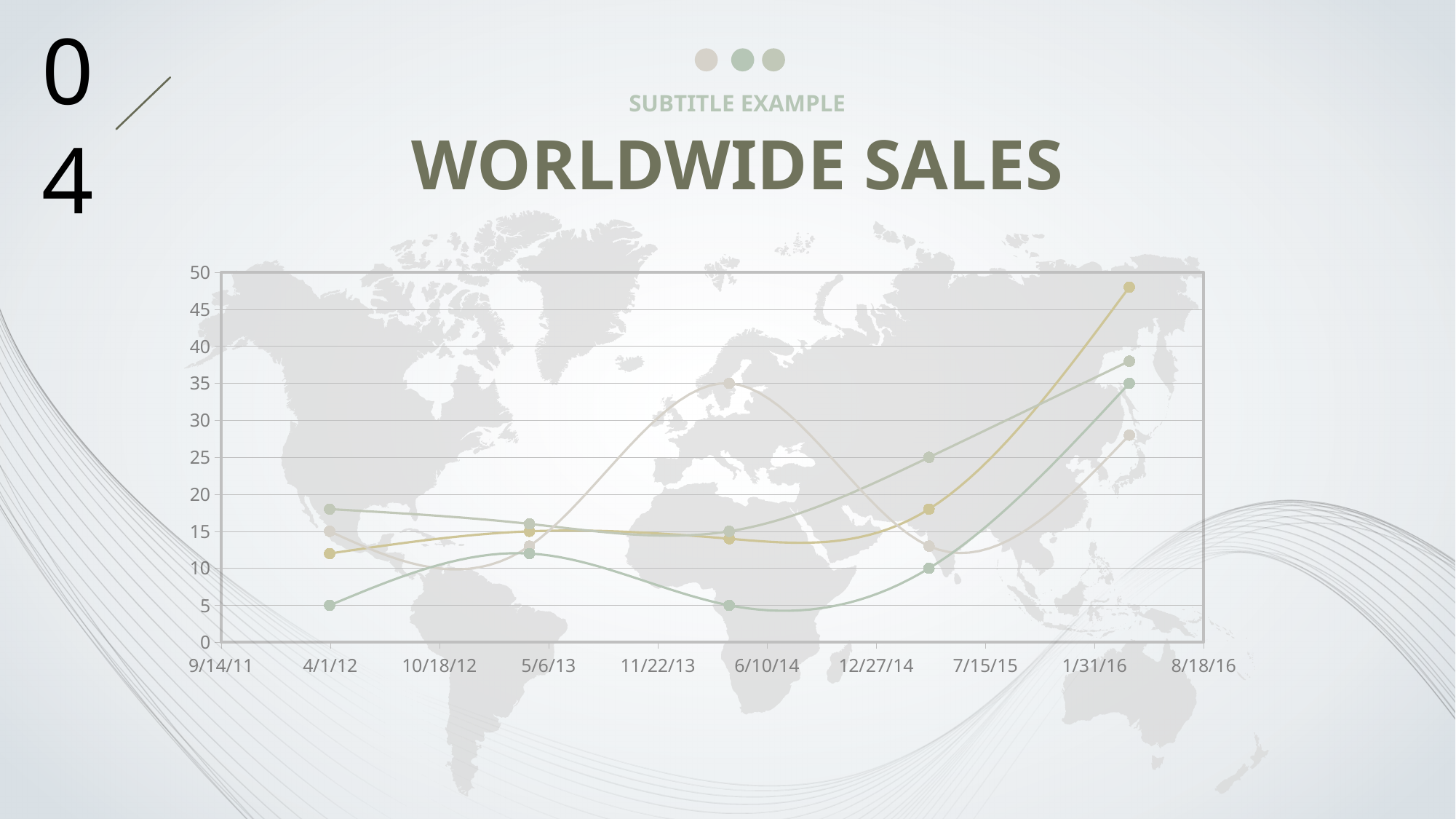
Is the lowest plotted point on the chart greater or less than 10? less What is the highest value shown on the y axis of the chart? 50 How many data points does each line on the chart have? 5 What is the title of the chart on the slide? WORLDWIDE SALES Do the lines on the chart rise or fall between the 7/15/15 and 1/31/16 labels? rise Is the final point of the yellow line greater or less than 40? greater What type of chart is shown on the slide? line chart How many date labels are shown on the x axis of the chart? 10 How many lines are plotted on the chart? 4 Is the highest plotted point on the chart greater or less than 45? greater What is the first date label on the x axis of the chart? 9/14/11